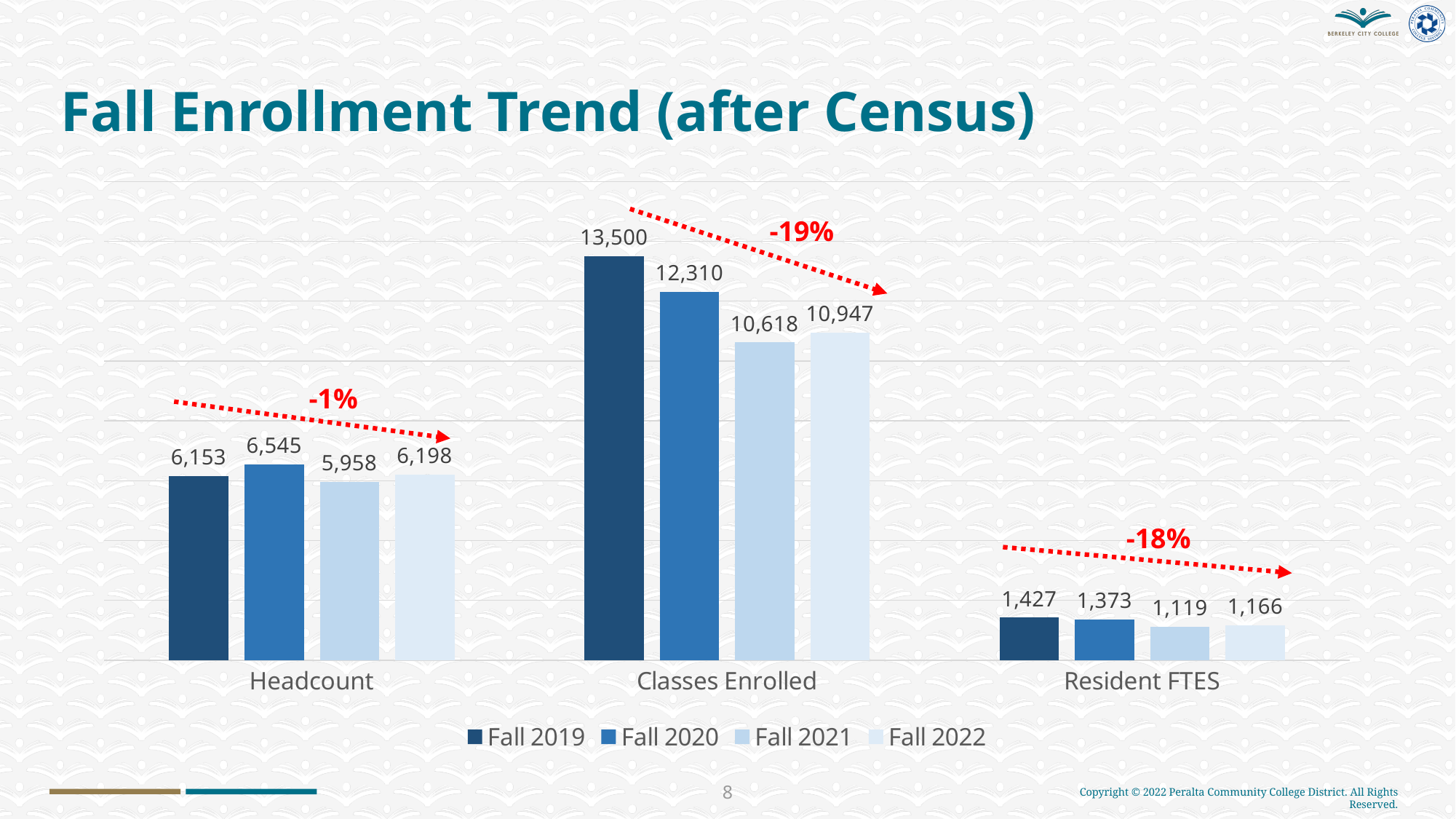
What is the Classes Enrolled value for Fall 2021? 10,618 Which is larger, the Resident FTES value for Fall 2019 or for Fall 2020? Fall 2019 What kind of chart is shown on the slide? Bar chart What is the Resident FTES value for Fall 2022? 1,166 What is the difference between the Classes Enrolled values for Fall 2019 and Fall 2022? 2,553 How many categories are shown on the x axis? 3 What is the Headcount value for Fall 2020? 6,545 What is the Classes Enrolled value for Fall 2019? 13,500 Which year has the lowest Headcount value? Fall 2021 How many series does the legend list? 4 Which year has the highest Classes Enrolled value? Fall 2019 What percentage change is annotated above the Classes Enrolled bars? -19%